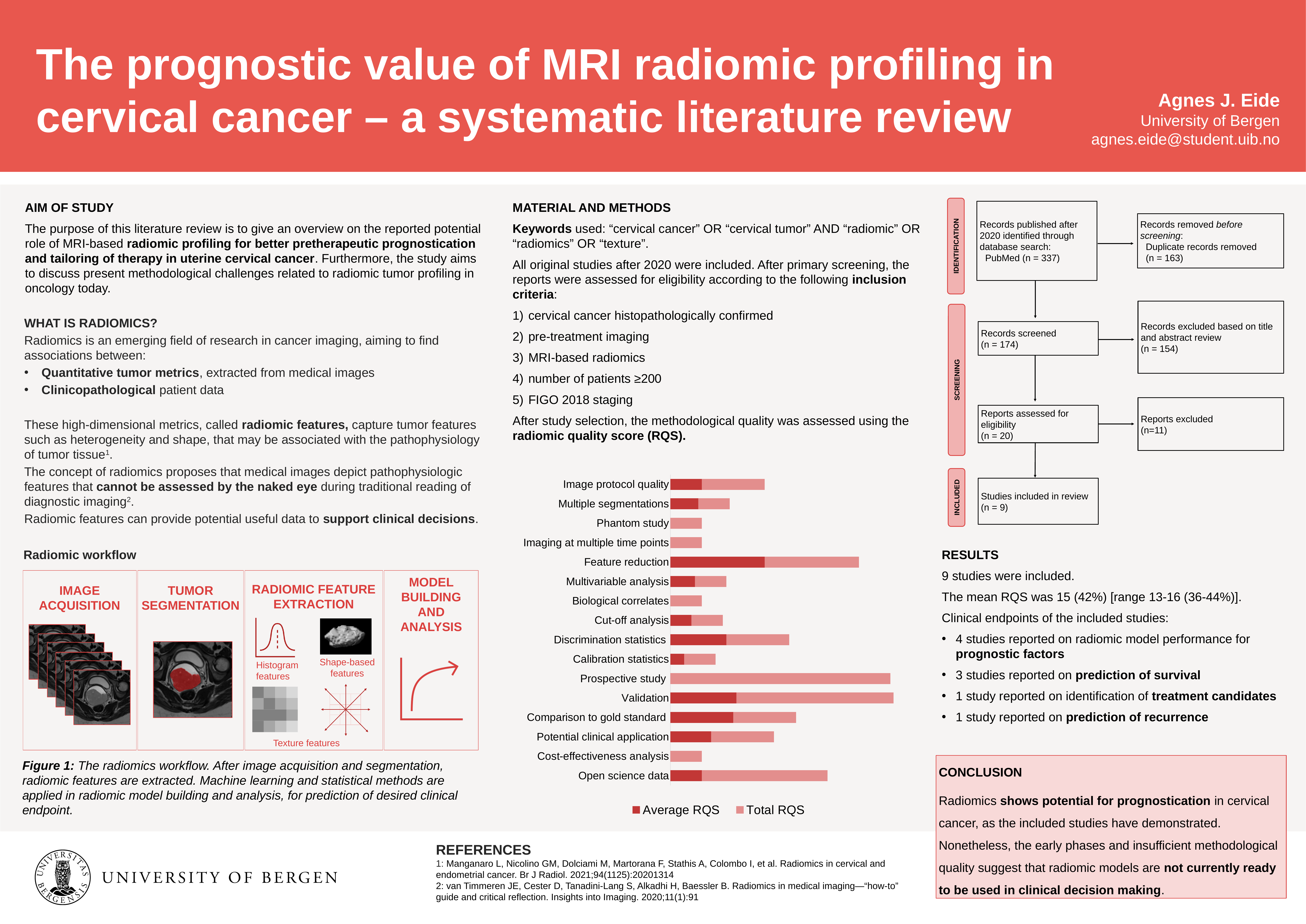
How many categories are plotted in the bar chart? 16 Which has the longer total bar in the chart: Discrimination statistics or Calibration statistics? Discrimination statistics Which has the longer total bar in the chart: Image protocol quality or Multiple segmentations? Image protocol quality Which has the longer total bar in the chart: Feature reduction or Multivariable analysis? Feature reduction Which category has the longest Average RQS segment in the bar chart? Feature reduction Which category is listed first (at the top) of the bar chart? Image protocol quality What are the two series named in the legend of the bar chart? Average RQS and Total RQS What kind of chart is shown on the slide? bar chart How many series does the legend of the bar chart list? 2